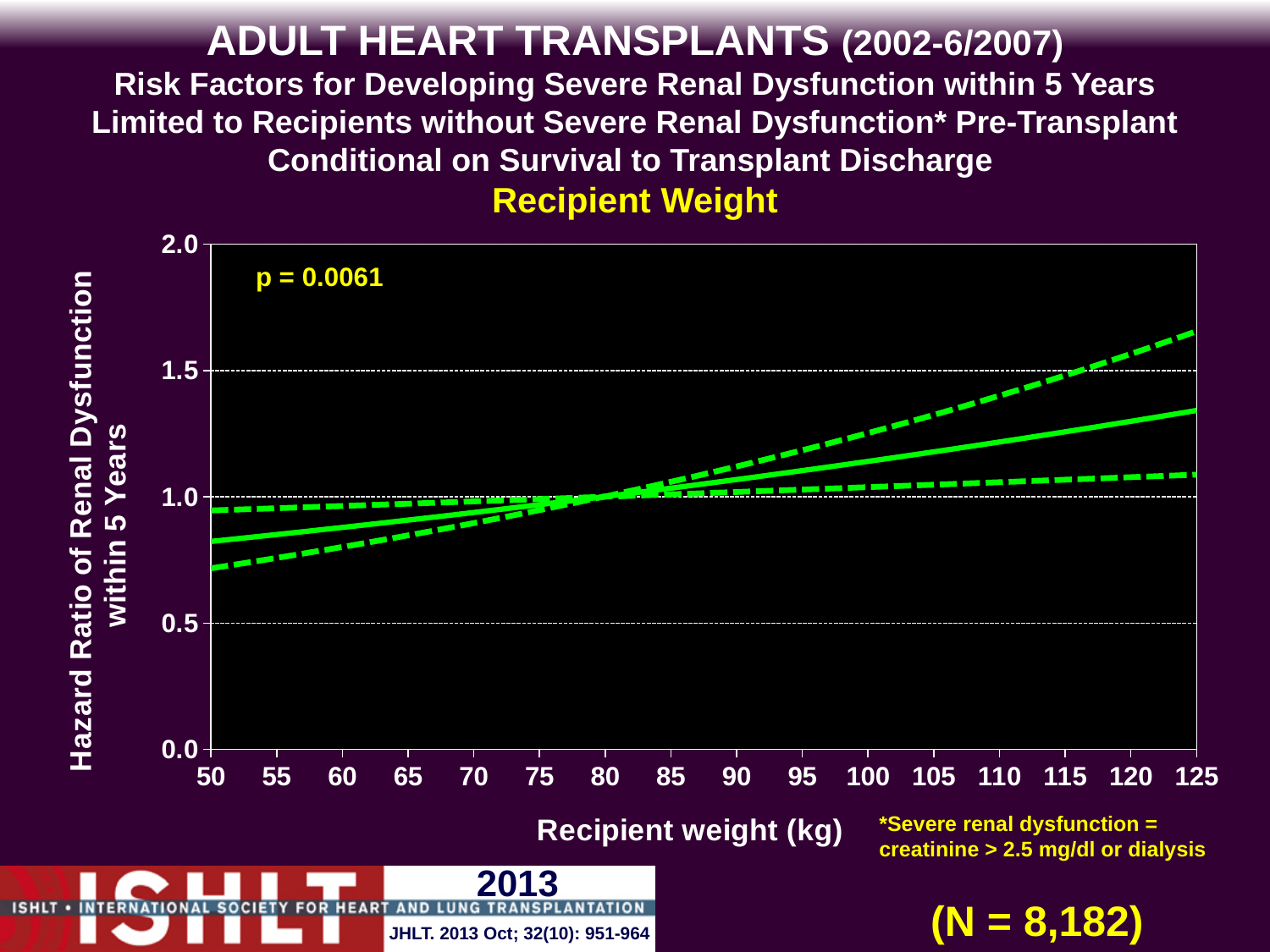
Is the upper dashed line at a recipient weight of 125 kg greater or less than 1.5? greater Does the solid hazard ratio line rise or fall as recipient weight increases from 50 to 125 kg? rise Is the hazard ratio on the solid line at a recipient weight of 125 kg greater or less than 1.0? greater Is the hazard ratio on the solid line at a recipient weight of 50 kg greater or less than 1.0? less What sample size (N) is shown on the slide? N = 8,182 What kind of chart is shown on the slide? line chart How many lines are plotted on the chart? 3 What p-value is printed on the chart? p = 0.0061 How many tick labels are shown on the recipient weight (x) axis? 16